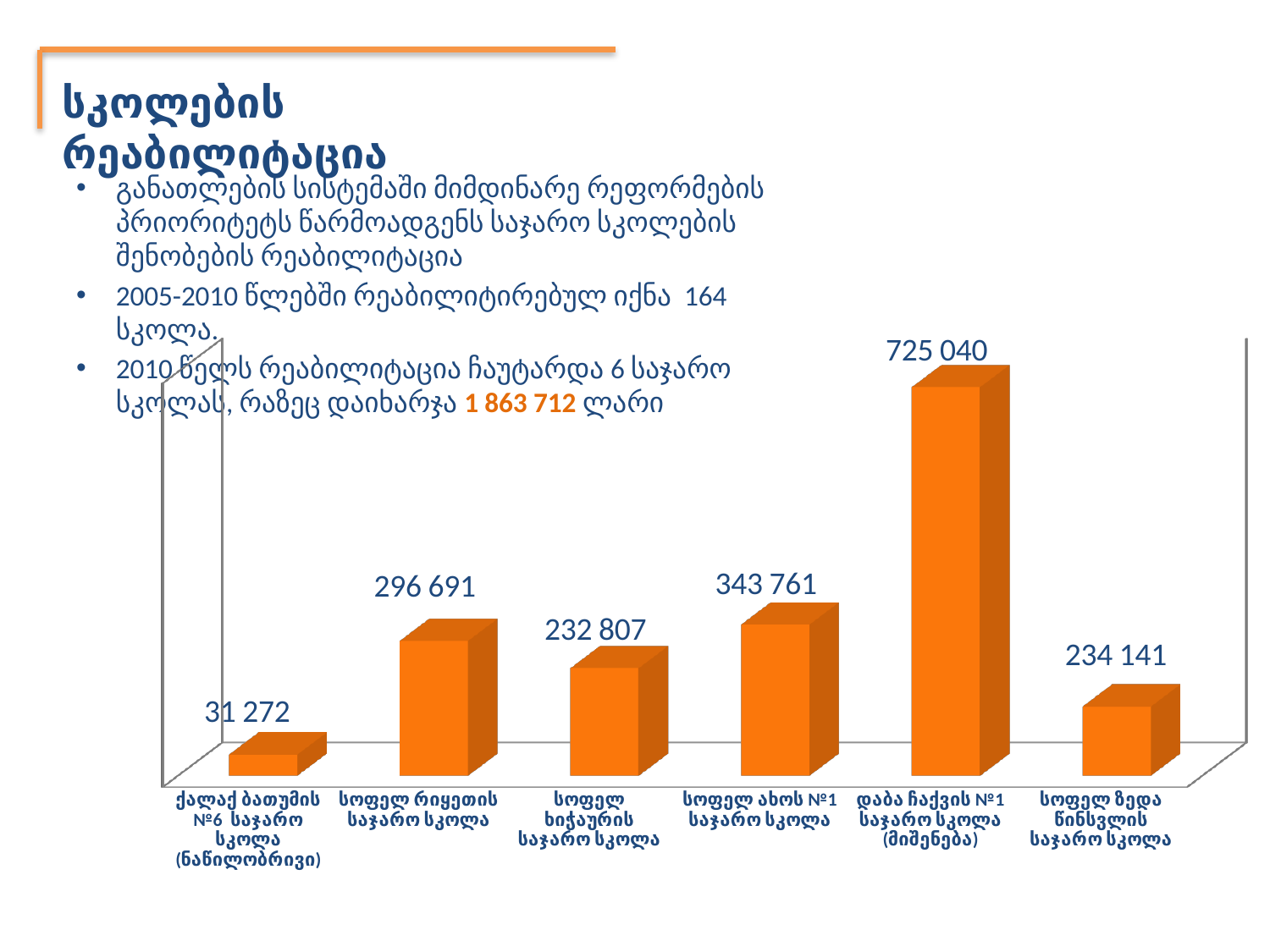
Which is larger: the value for სოფელ ახოს №1 საჯარო სკოლა or the value for სოფელ რიყეთის საჯარო სკოლა? სოფელ ახოს №1 საჯარო სკოლა What value is shown for სოფელ ახოს №1 საჯარო სკოლა? 343 761 What type of chart is shown on the slide? Bar chart What is the difference between the values for სოფელ რიყეთის საჯარო სკოლა and სოფელ ხიჭაურის საჯარო სკოლა? 63 884 What is the total of all six values shown in the chart? 1 863 712 Which school has the highest value in the chart? დაბა ჩაქვის №1 საჯარო სკოლა (მშენება) What is the difference between the values for დაბა ჩაქვის №1 საჯარო სკოლა (მშენება) and სოფელ ახოს №1 საჯარო სკოლა? 381 279 What value is shown for ქალაქ ბათუმის №6 საჯარო სკოლა (ნაწილობრივი)? 31 272 How many schools (bars) are shown in the chart? 6 What value is shown for დაბა ჩაქვის №1 საჯარო სკოლა (მშენება)? 725 040 Which school has the lowest value in the chart? ქალაქ ბათუმის №6 საჯარო სკოლა (ნაწილობრივი) What value is shown for სოფელ რიყეთის საჯარო სკოლა? 296 691